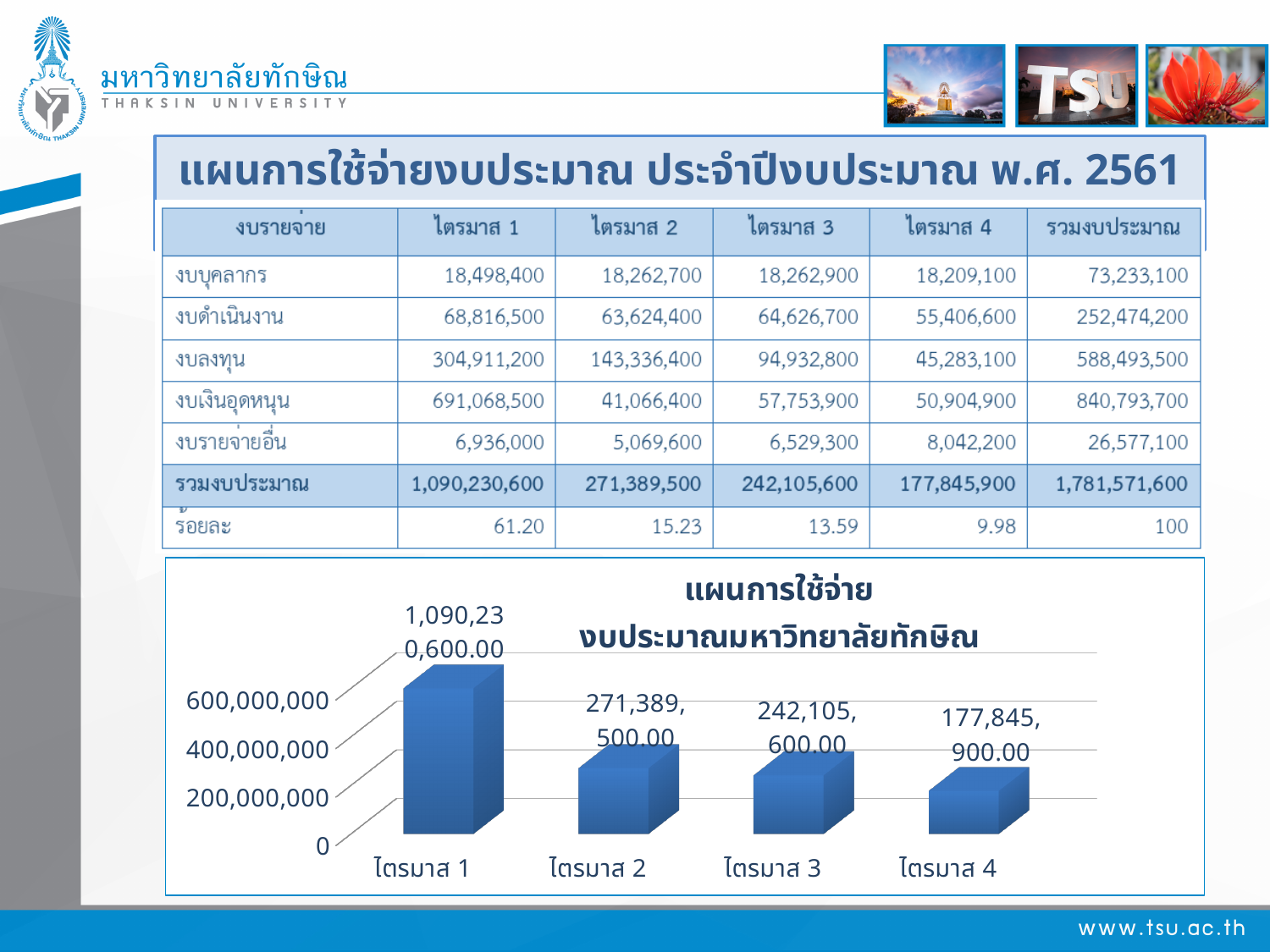
What is the value for ไตรมาส 2 in the bar chart? 271,389,500.00 Do the values in the bar chart rise or fall from ไตรมาส 1 to ไตรมาส 4? fall Which quarter has the highest value in the bar chart? ไตรมาส 1 What is the value for ไตรมาส 1 in the bar chart? 1,090,230,600.00 What type of chart is shown on the slide? bar chart In the bar chart, which is larger: the value for ไตรมาส 2 or ไตรมาส 3? ไตรมาส 2 In the bar chart, what is the difference between the values for ไตรมาส 1 and ไตรมาส 2? 818,841,100.00 Which quarter has the lowest value in the bar chart? ไตรมาส 4 What is the value for ไตรมาส 4 in the bar chart? 177,845,900.00 How many quarters (categories) are plotted in the bar chart? 4 In the bar chart, what is the difference between the values for ไตรมาส 3 and ไตรมาส 4? 64,259,700.00 What is the value for ไตรมาส 3 in the bar chart? 242,105,600.00